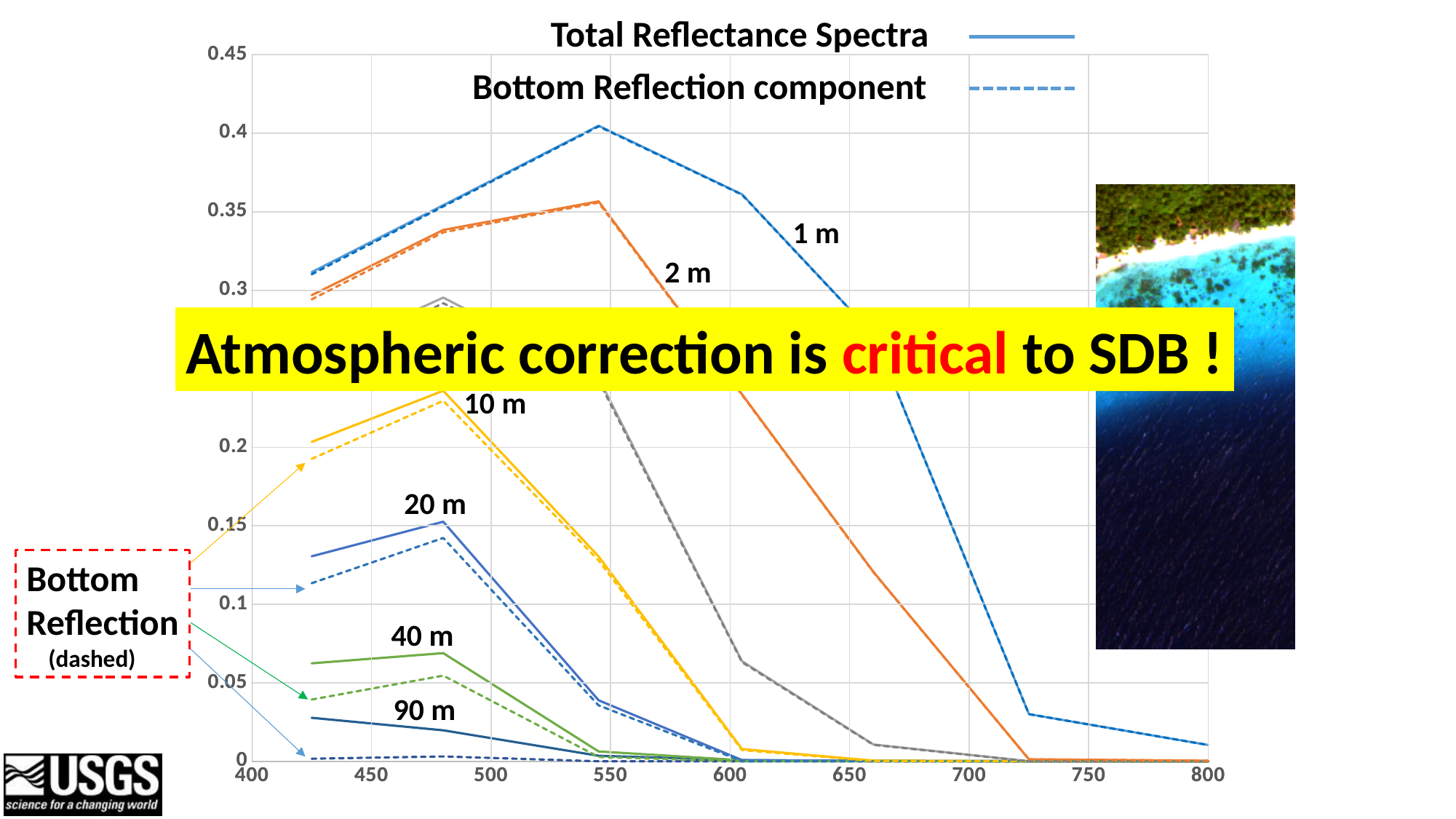
According to the legend, what does the solid line style represent? Total Reflectance Spectra Which labelled depth series reaches the highest reflectance value on the chart? 1 m Is the value of the 2 m series at 550 greater or less than 0.3? greater Is the value of the 1 m series at 550 greater or less than 0.35? greater Is the value of the 90 m solid series at 425 greater or less than 0.05? less How many entries does the legend at the top of the chart list? 2 Does the 1 m series rise or fall between 550 and 800 on the x axis? fall What kind of chart is shown on the slide? line chart At 550, which is larger: the 1 m series or the 2 m series? 1 m Which labelled depth series has the lowest reflectance values on the chart? 90 m According to the legend, what does the dashed line style represent? Bottom Reflection component